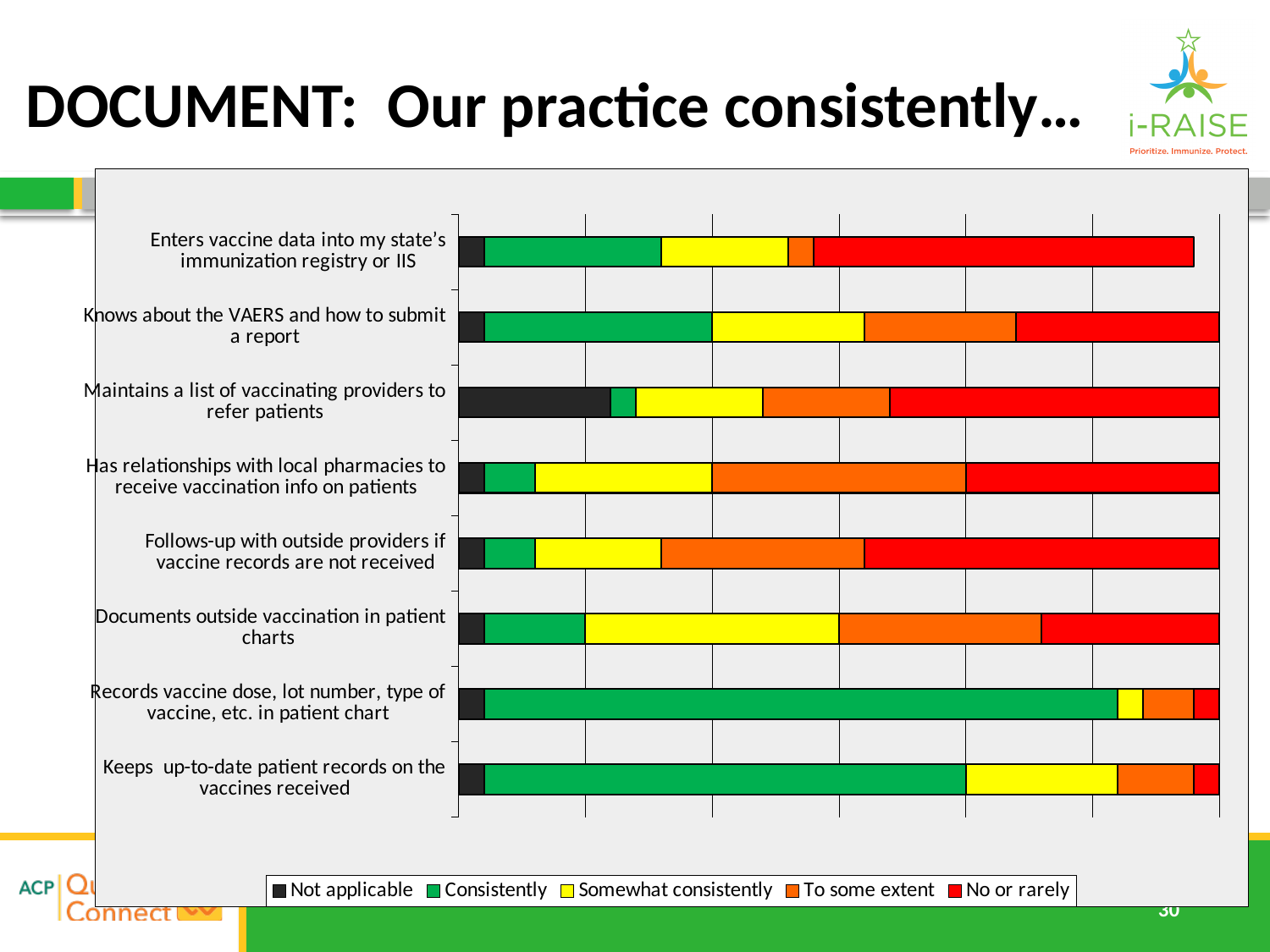
What kind of chart is shown on the slide? Stacked bar chart How many categories (practice statements) are plotted on the chart? 8 What is the first legend entry listed? Not applicable Is the 'Consistently' segment larger for 'Knows about the VAERS and how to submit a report' or for 'Enters vaccine data into my state's immunization registry or IIS'? Knows about the VAERS and how to submit a report Which category has the largest 'No or rarely' segment? Enters vaccine data into my state's immunization registry or IIS Which category has the largest 'To some extent' segment? Has relationships with local pharmacies to receive vaccination info on patients Which category has the largest 'Not applicable' segment? Maintains a list of vaccinating providers to refer patients Is the 'Consistently' segment larger for 'Records vaccine dose, lot number, type of vaccine, etc. in patient chart' or for 'Keeps up-to-date patient records on the vaccines received'? Records vaccine dose, lot number, type of vaccine, etc. in patient chart How many series does the legend list? 5 Which colour represents 'No or rarely' in the legend? Red